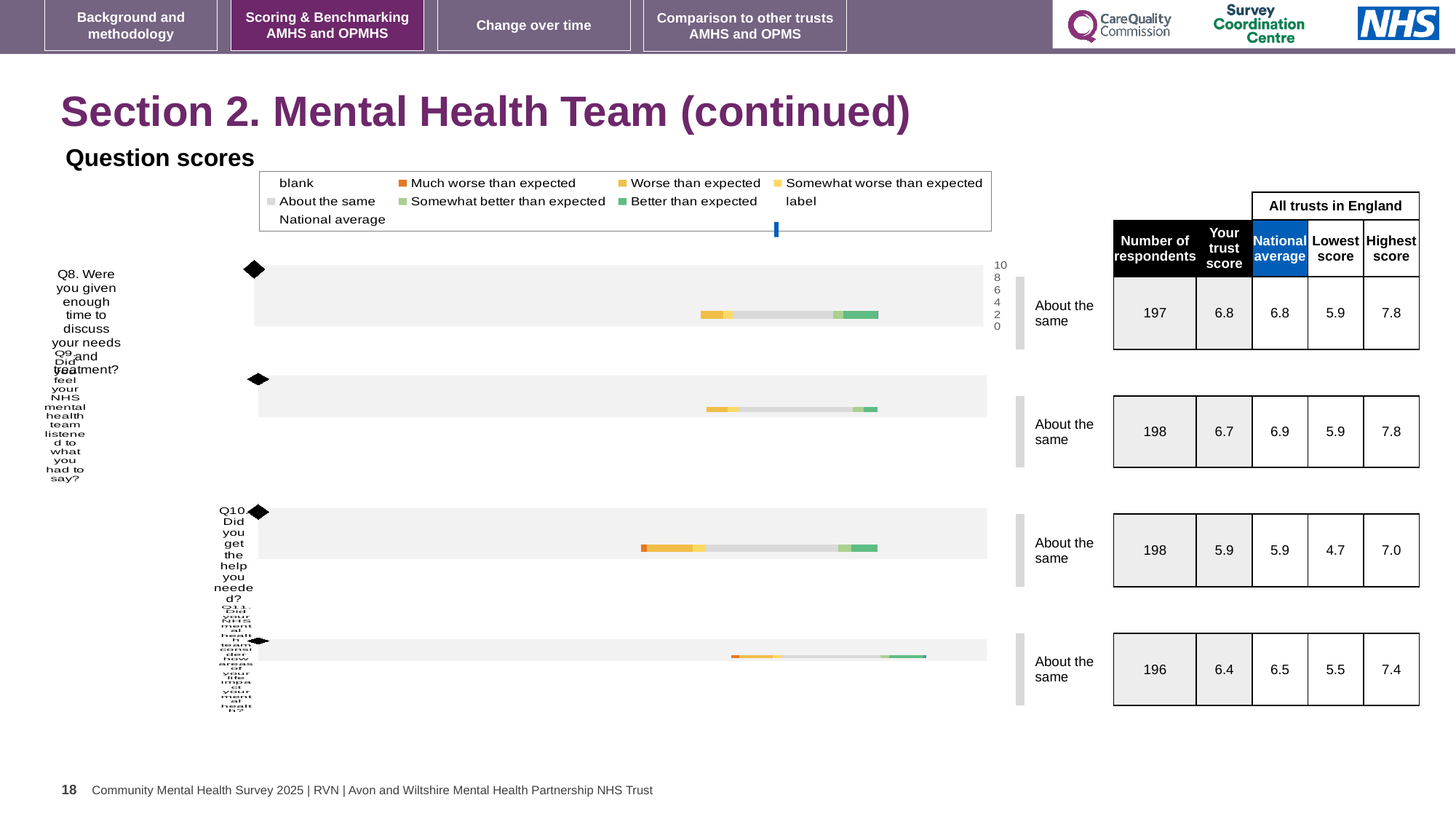
What is the National average shown for Q9 (Did you feel your NHS mental health team listened to what you had to say)? 6.9 How many respondents are shown for Q9? 198 What is the difference between the National average and 'Your trust score' for Q9? 0.2 What is the 'Your trust score' value shown for Q8 (Were you given enough time to discuss your needs and treatment)? 6.8 What is the Lowest score shown for Q10 (Did you get the help you needed)? 4.7 What colour represents 'Much worse than expected' in the legend? orange Which question has the lowest 'Your trust score' among Q8 to Q11? Q10 How many questions (Q8 to Q11) have a bar chart on the slide? 4 Which has the higher 'Your trust score', Q8 or Q11? Q8 What kind of chart is used to show the question scores for Q8 to Q11? bar chart What is the Highest score shown for Q11 (Did your NHS mental health team consider how areas of your life impact your mental health)? 7.4 What benchmark category label is shown to the right of each of the four bar charts? About the same